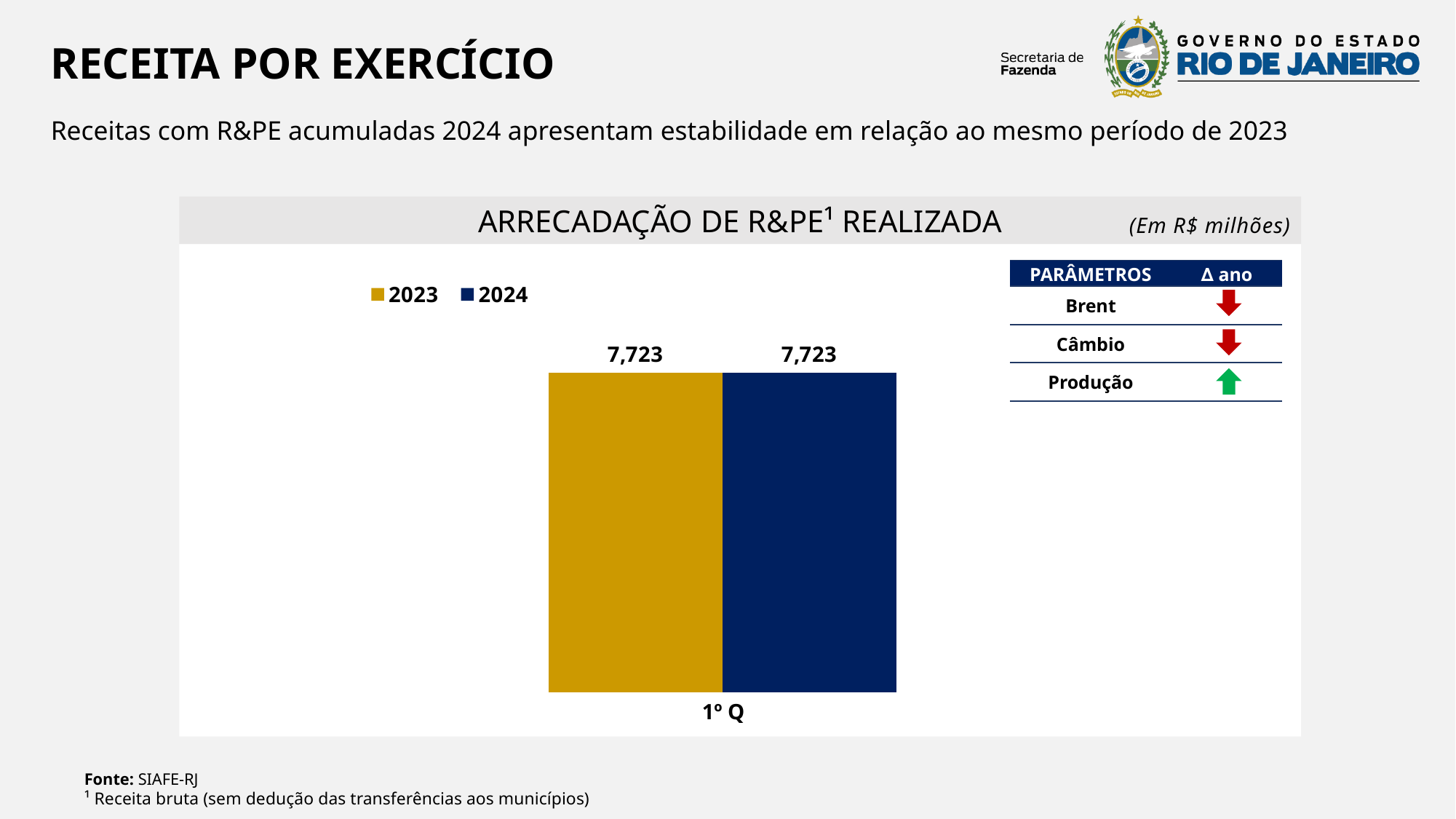
What is the title of the chart? ARRECADAÇÃO DE R&PE¹ REALIZADA Which series is shown in dark blue? 2024 How many series does the legend list? 2 What is the value for 2023 in 1º Q? 7,723 What is the label of the single category on the x axis? 1º Q What is the difference between the 2024 and 2023 values for 1º Q? 0 What kind of chart is shown? bar chart What is the value for 2024 in 1º Q? 7,723 How many categories are shown on the x axis? 1